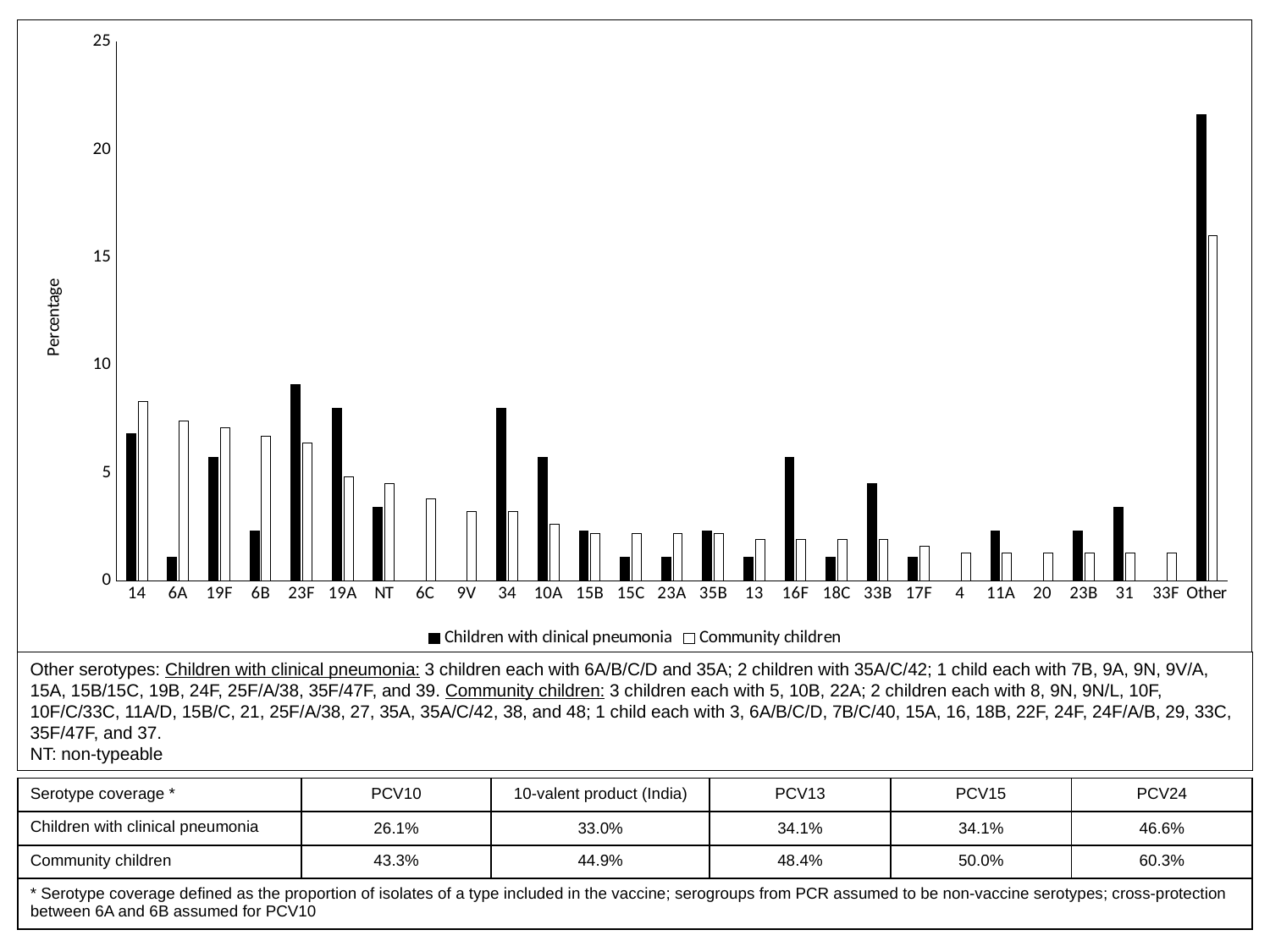
For serotype 34, which series has the larger value: Children with clinical pneumonia or Community children? Children with clinical pneumonia Is the value for 23F in the Children with clinical pneumonia series greater or less than 5? greater Which category has the highest value for Community children? Other Is the value for Other in the Children with clinical pneumonia series greater or less than 20? greater How many series does the chart's legend list? 2 Is the value for 6A in the Children with clinical pneumonia series greater or less than 5? less Which category has the highest value for Children with clinical pneumonia? Other For serotype 6A, which series has the larger value: Children with clinical pneumonia or Community children? Community children How many serotype categories are shown along the x axis of the chart? 27 What is the label on the vertical axis of the chart? Percentage What kind of chart is shown on the slide? bar chart